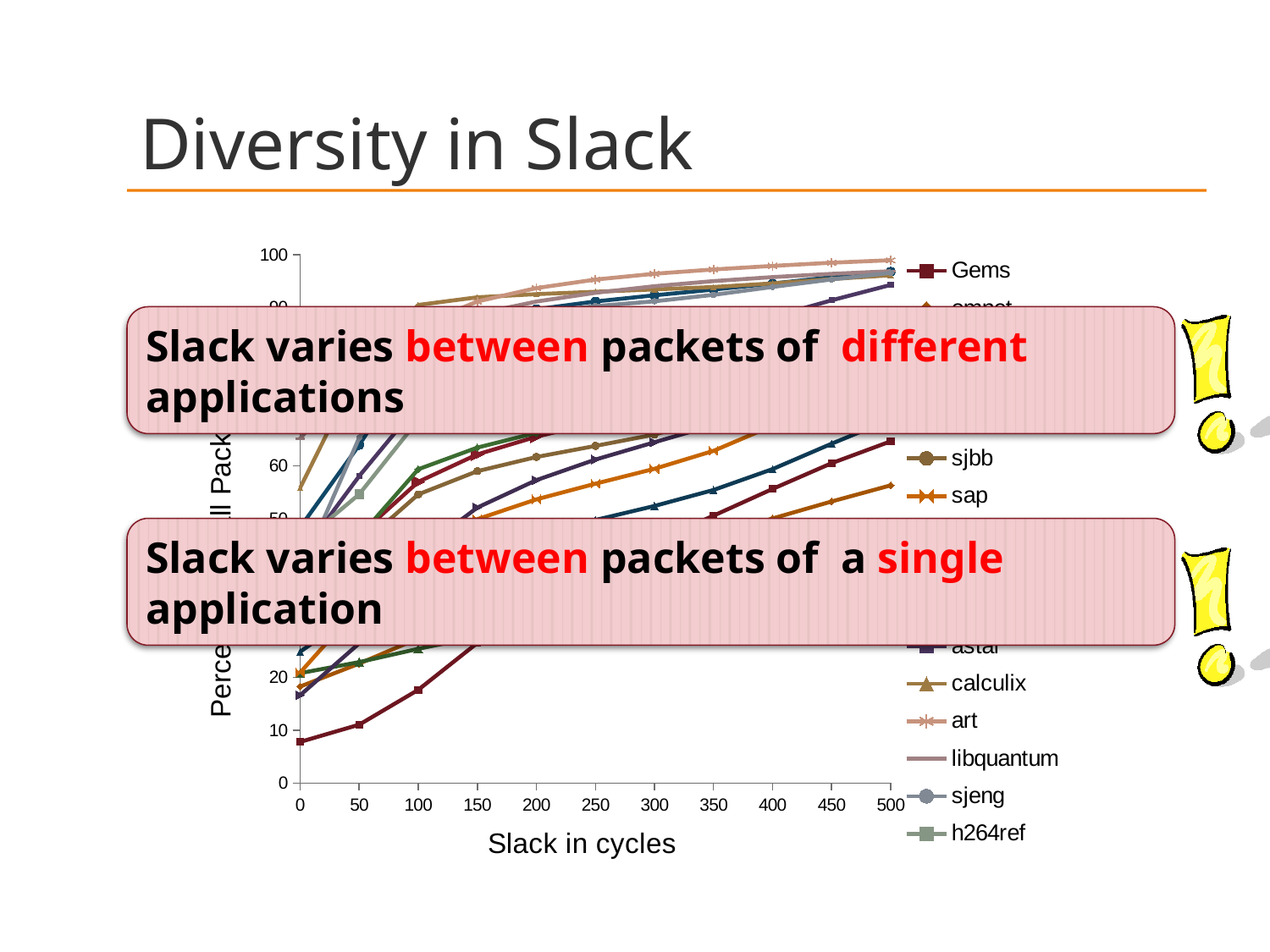
At a slack of 500 cycles, which is larger: the value for art or the value for Gems? art Do the values for Gems rise or fall as slack in cycles increases? rise What is the title of the x axis of the chart? Slack in cycles Is the value for Gems at a slack of 500 cycles greater or less than 60? greater How many tick marks are labelled on the x axis of the chart? 11 What kind of chart is shown on the slide? line chart Is the value for Gems at a slack of 0 cycles greater or less than 10? less Is the value for art at a slack of 500 cycles greater or less than 90? greater Which series is listed first in the chart's legend? Gems Which series has the lowest value at a slack of 0 cycles? Gems Which series has the highest value at a slack of 500 cycles? art